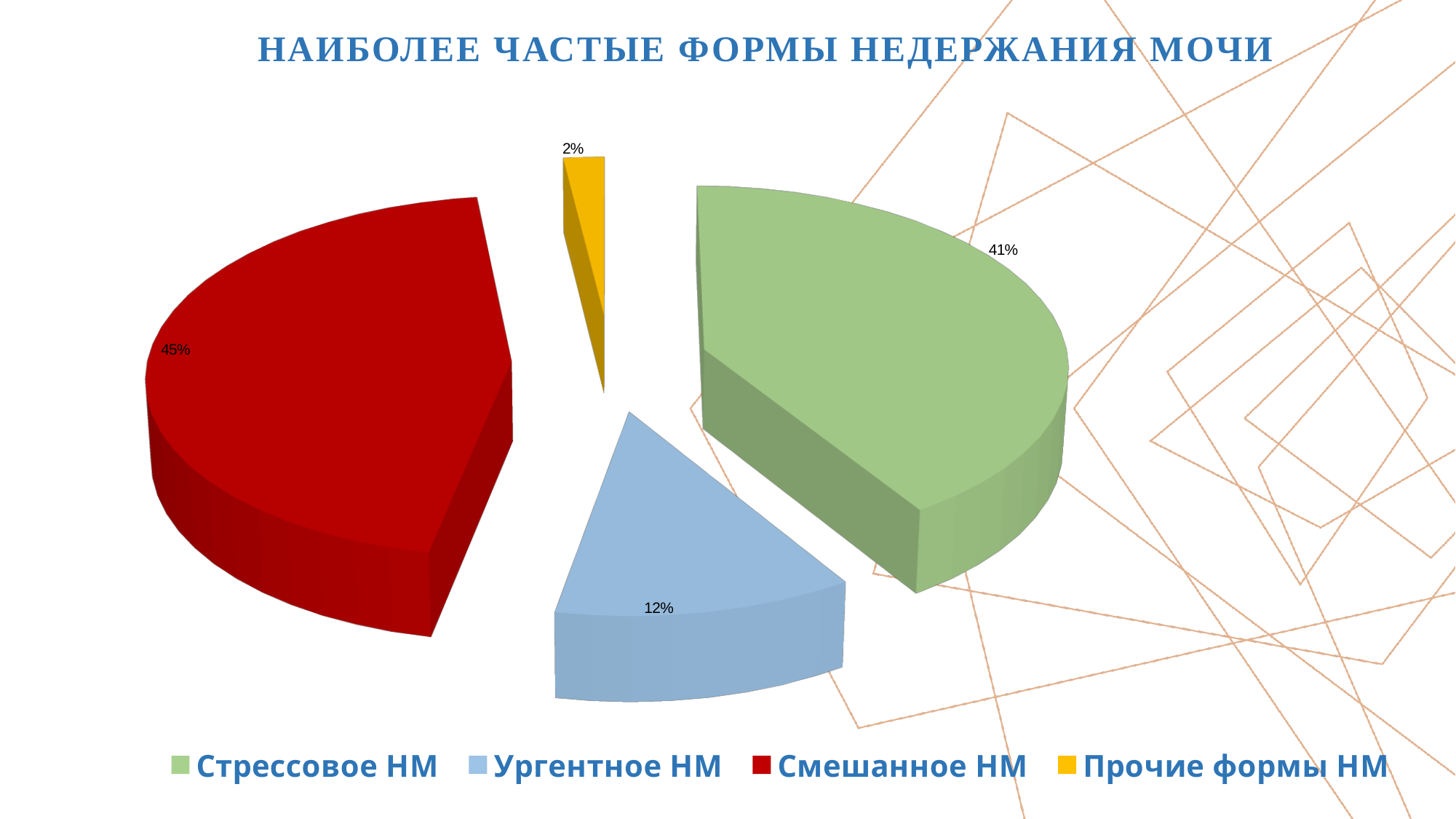
What is the title of the chart? НАИБОЛЕЕ ЧАСТЫЕ ФОРМЫ НЕДЕРЖАНИЯ МОЧИ Which is larger, the share for Ургентное НМ or the share for Прочие формы НМ? Ургентное НМ Which category has the largest share of the pie? Смешанное НМ What share of the pie does Ургентное НМ have? 12% How many categories does the pie chart show? 4 What share of the pie does Стрессовое НМ have? 41% What kind of chart is shown on the slide? pie chart What share of the pie does Прочие формы НМ have? 2% What share of the pie does Смешанное НМ have? 45% What is the difference in percentage points between Смешанное НМ and Стрессовое НМ? 4 What is the difference in percentage points between Стрессовое НМ and Ургентное НМ? 29 Which category has the smallest share of the pie? Прочие формы НМ